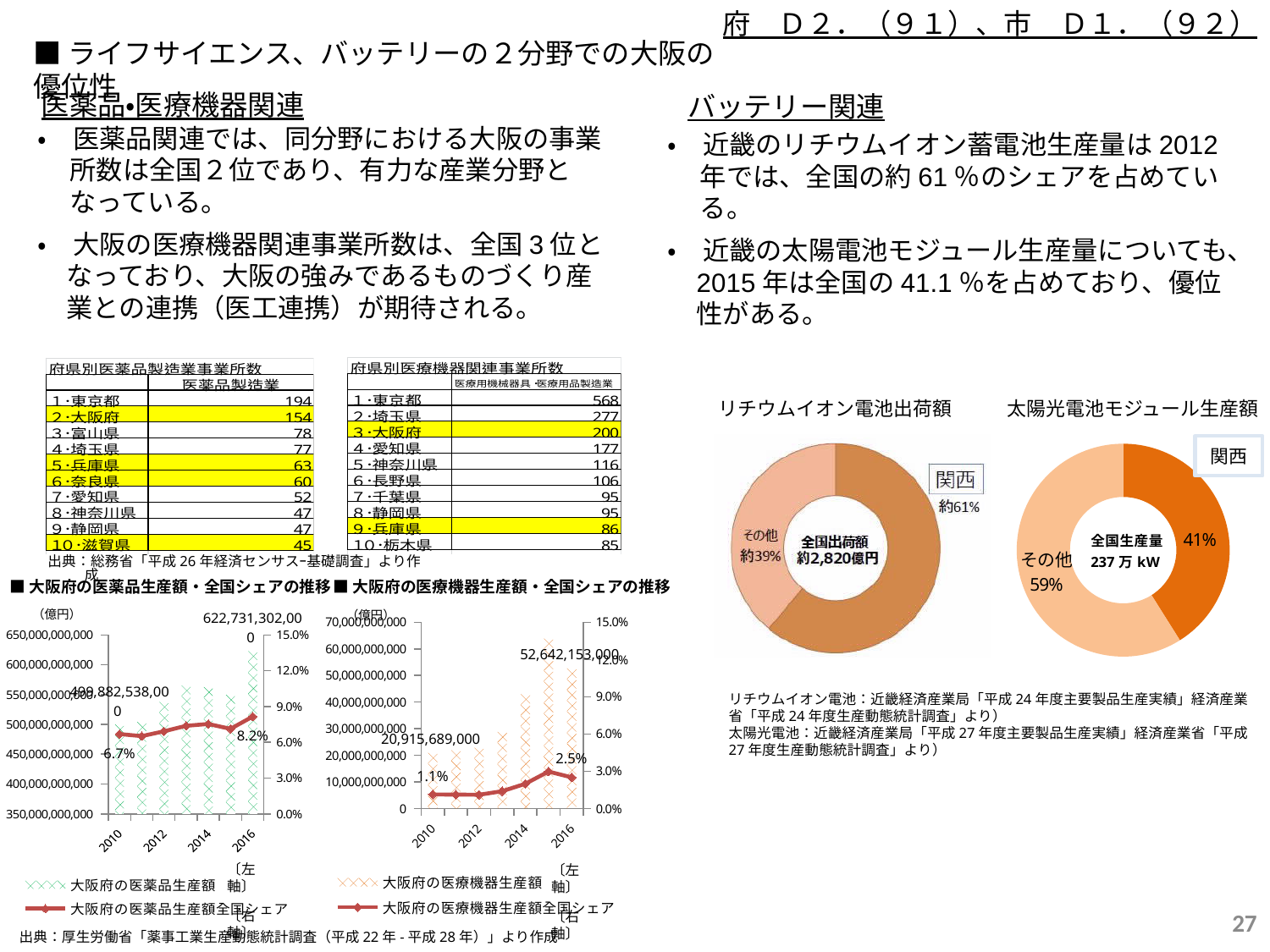
In the donut chart titled 太陽光電池モジュール生産額, which slice is larger, 関西 or その他? その他 In the chart titled 大阪府の医療機器生産額・全国シェアの推移, does the 全国シェア line rise or fall from 2010 to 2016? rise In the donut chart titled 太陽光電池モジュール生産額, what share does 関西 hold? 41% In the donut chart titled リチウムイオン電池出荷額, what share does 関西 hold? 約61% In the chart titled 大阪府の医療機器生産額・全国シェアの推移, what is the difference between the 2016 share (2.5%) and the 2010 share (1.1%)? 1.4 percentage points In the donut chart titled リチウムイオン電池出荷額, what is the 全国出荷額 shown in the centre? 約2,820億円 How many slices does the donut chart titled リチウムイオン電池出荷額 have? 2 In the chart titled 大阪府の医薬品生産額・全国シェアの推移, what is the 全国シェア value labelled for 2010? 6.7% In the chart titled 大阪府の医薬品生産額・全国シェアの推移, what is the 全国シェア value labelled for 2016? 8.2% How many series does the legend list for the chart titled 大阪府の医薬品生産額・全国シェアの推移? 2 In the donut chart titled リチウムイオン電池出荷額, what share does その他 hold? 約39% In the donut chart titled 太陽光電池モジュール生産額, what is the 全国生産量 shown in the centre? 237万kW